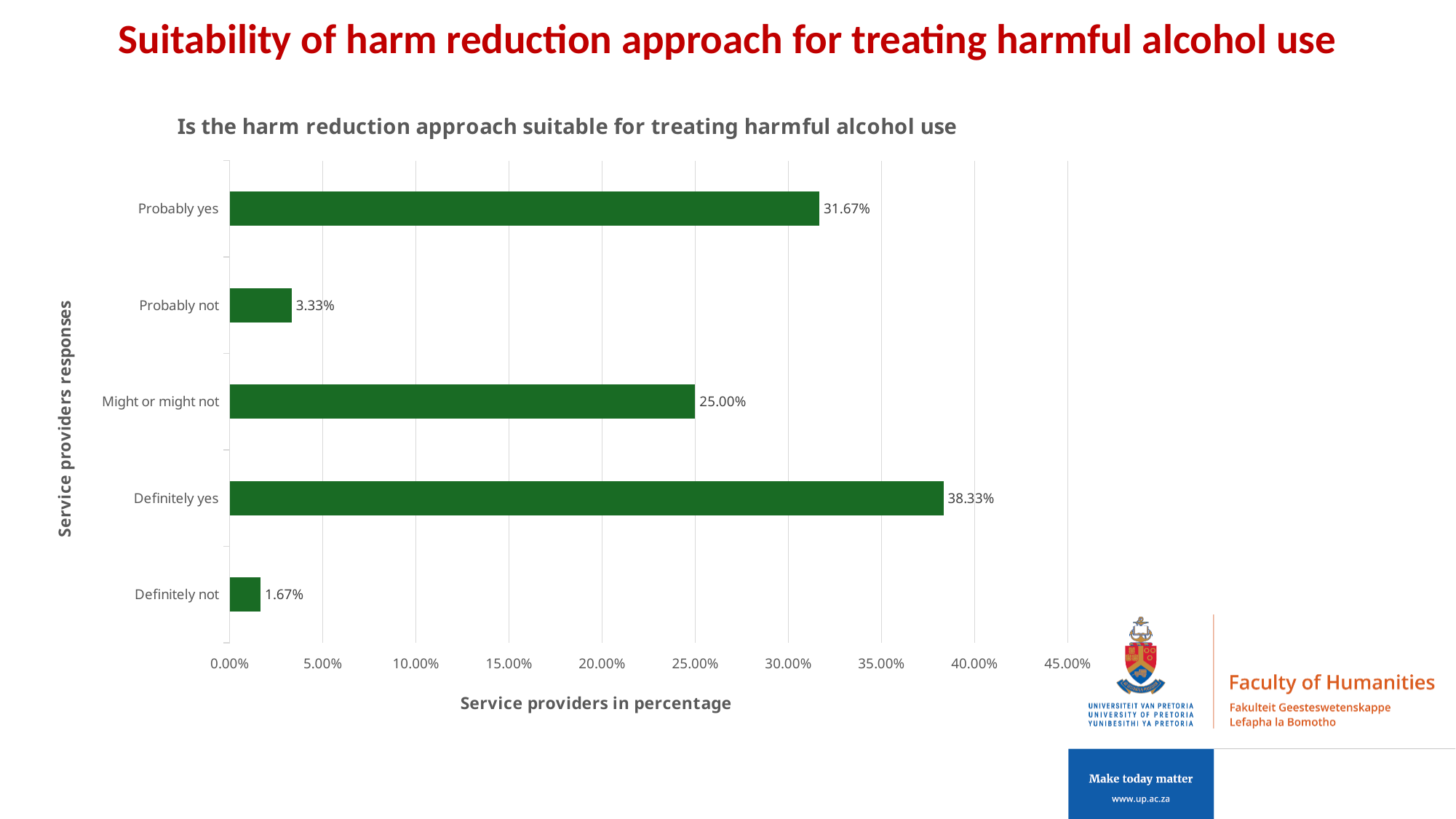
What is the value for Might or might not? 25.00% What is the value for Definitely yes? 38.33% What kind of chart is shown on the slide? Bar chart Which is larger, the value for Probably not or the value for Might or might not? Might or might not Is the value for Probably yes greater or less than 30.00%? greater What is the difference between the values for Definitely yes and Probably yes? 6.66% What is the value for Definitely not? 1.67% How many response categories are shown in the chart? 5 Which response has the highest value? Definitely yes What is the label of the horizontal axis? Service providers in percentage Which response has the lowest value? Definitely not What is the value for Probably yes? 31.67%